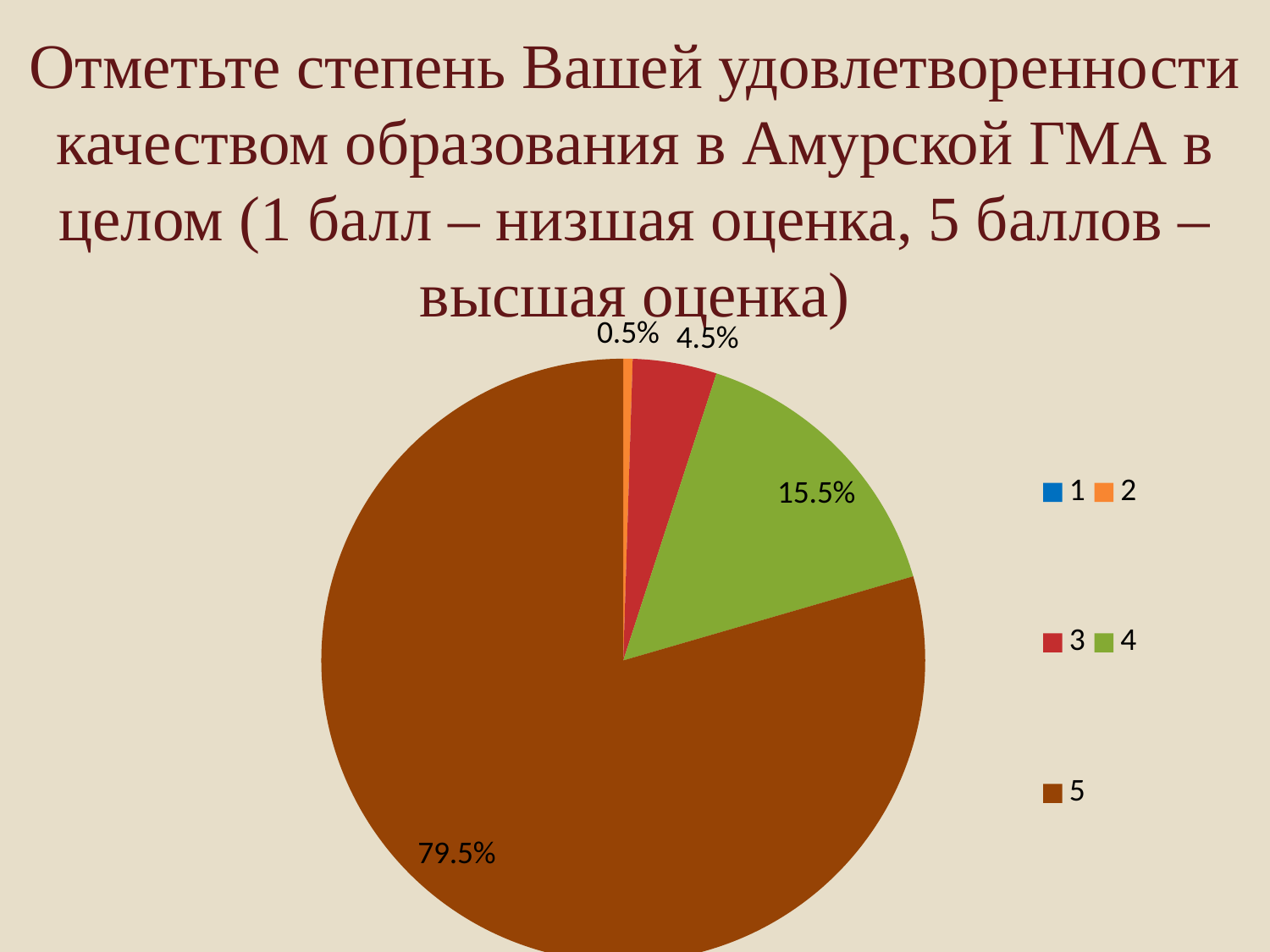
What share of the pie does category 4 have? 15.5% What colour is the slice for category 5? brown Which of the labelled slices is the smallest? 2 Which is larger, the share of category 3 or the share of category 4? 4 What kind of chart is shown on the slide? pie chart How many entries does the legend list? 5 What share of the pie does category 3 have? 4.5% What share of the pie does category 2 have? 0.5% Which category has the largest slice of the pie? 5 What is the difference between the shares of category 5 and category 4? 64% What share of the pie does category 5 have? 79.5% What is the difference between the shares of category 4 and category 3? 11%